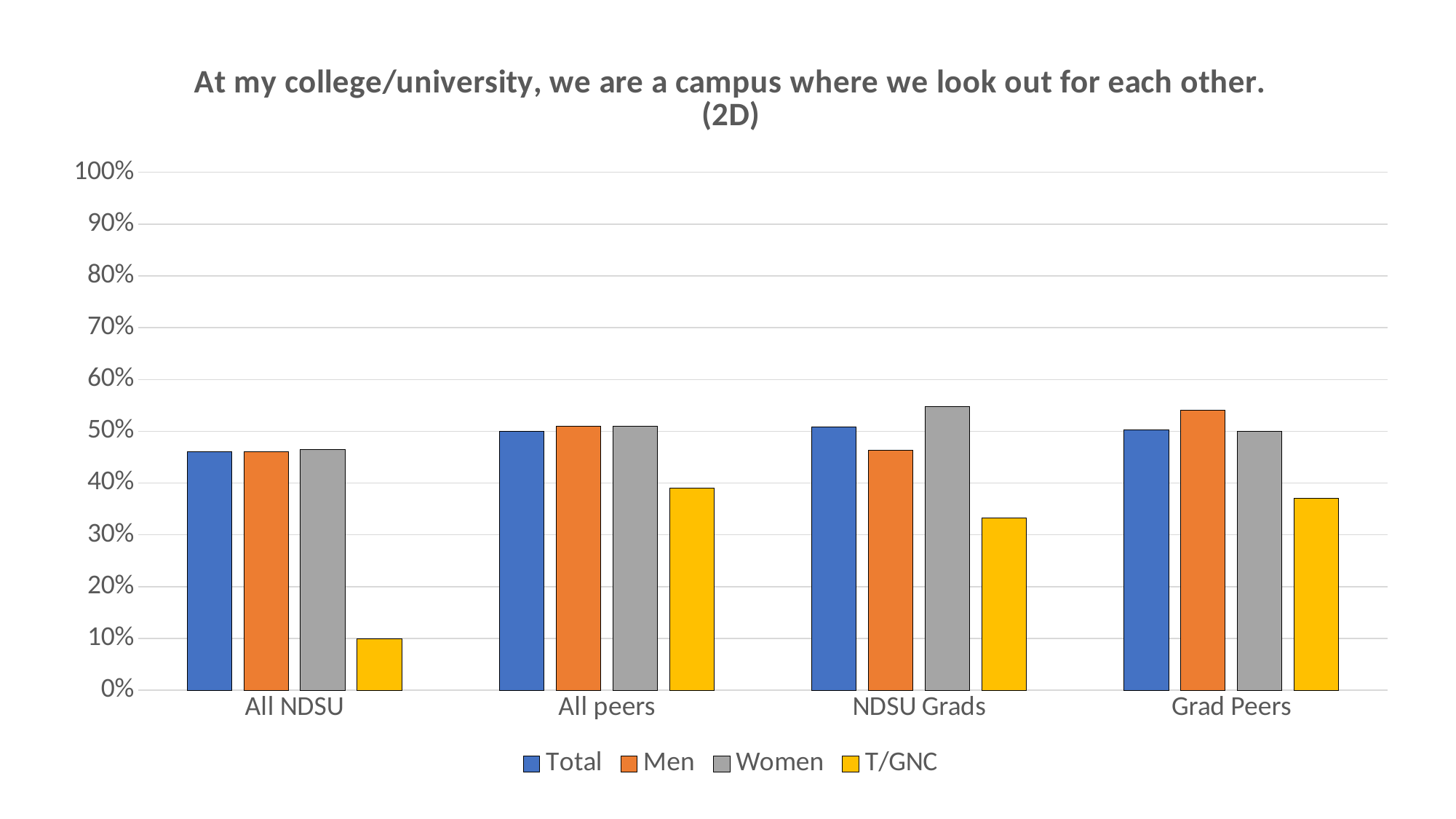
In which category is the T/GNC value lowest? All NDSU Which is larger: the T/GNC value for All peers or the T/GNC value for NDSU Grads? All peers What kind of chart is shown on the slide? bar chart How many categories are shown along the x axis? 4 Is the value for T/GNC in the NDSU Grads category greater or less than 30%? greater Within the NDSU Grads category, which series has the highest value? Women Which is larger: the Men value for Grad Peers or the Men value for NDSU Grads? Grad Peers Is the value for Total in the All NDSU category greater or less than 50%? less Is the value for T/GNC in the All NDSU category greater or less than 20%? less What colour represents the T/GNC series in the legend? yellow How many series does the legend list? 4